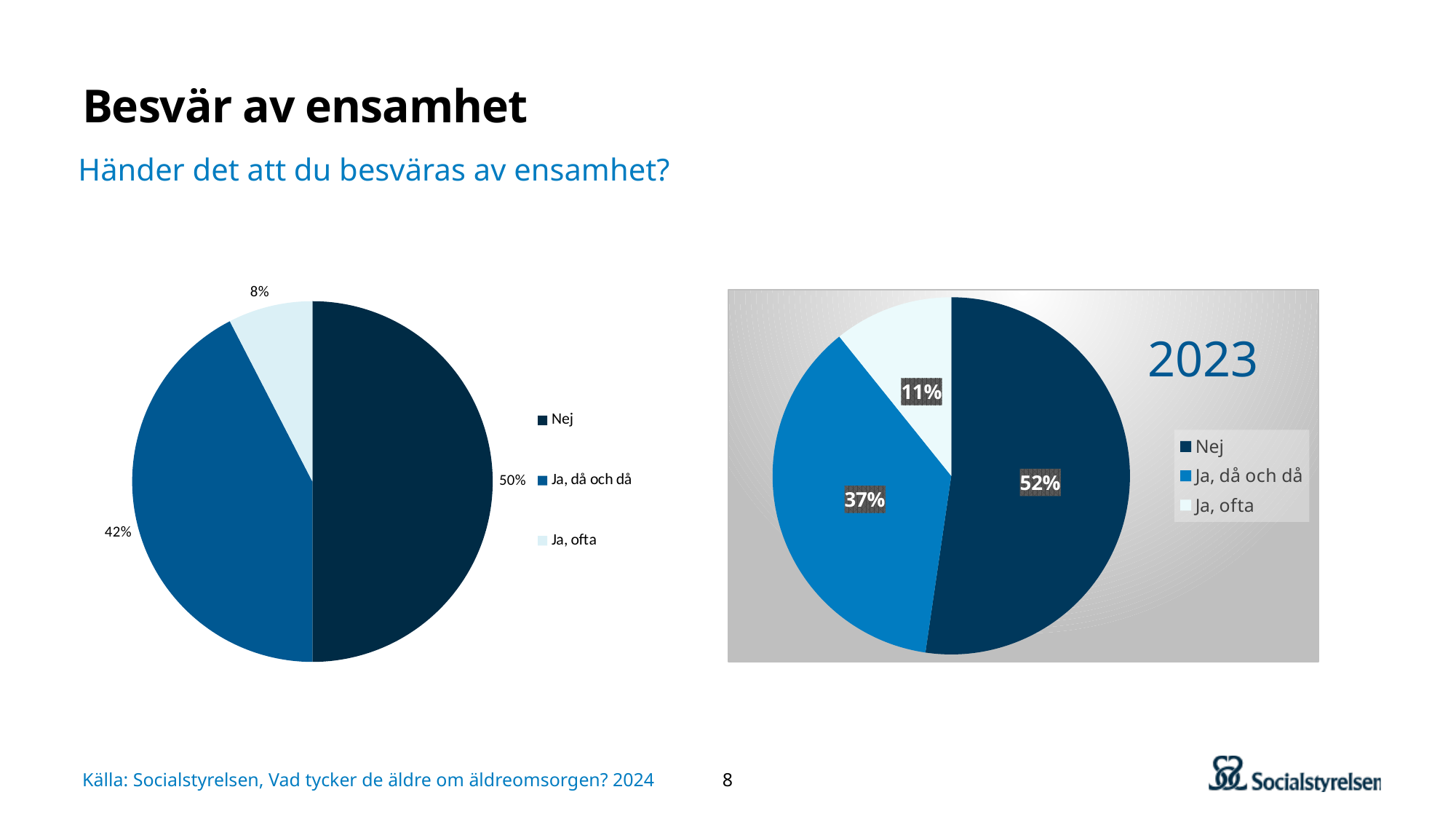
In the right pie chart labelled 2023, which category has the smallest share? Ja, ofta In the left pie chart, what is the value for "Ja, ofta"? 8% In the right pie chart labelled 2023, what is the value for "Nej"? 52% In the right pie chart labelled 2023, what is the value for "Ja, ofta"? 11% Which is larger: "Ja, ofta" in the left pie chart or "Ja, ofta" in the right pie chart labelled 2023? The right pie chart (2023) In the left pie chart, what is the value for "Nej"? 50% In the right pie chart labelled 2023, what is the difference between the "Nej" share and the "Ja, då och då" share? 15% How many categories does the left pie chart show? 3 What type of chart is the right chart labelled 2023? Pie chart In the left pie chart, which category has the largest share? Nej In the right pie chart labelled 2023, what is the value for "Ja, då och då"? 37% In the left pie chart, what is the value for "Ja, då och då"? 42%